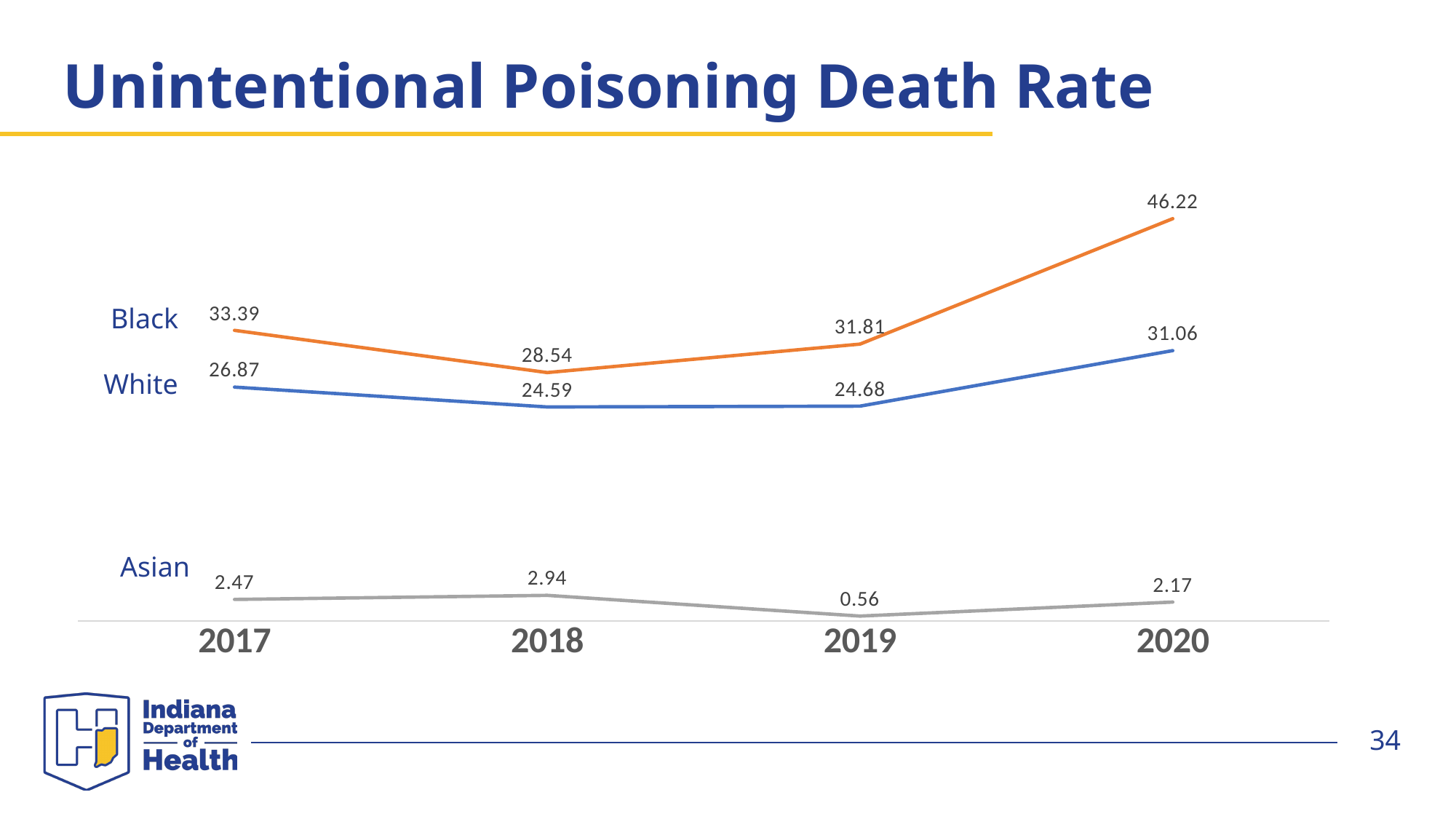
How many series are plotted on the chart? 3 What colour is the line for the Black series? Orange What is the unintentional poisoning death rate for White in 2018? 24.59 In which year is the Asian death rate lowest? 2019 How many years are shown on the x axis? 4 In which year is the Black death rate highest? 2020 What is the unintentional poisoning death rate for Asian in 2019? 0.56 What is the difference between the Black and White death rates in 2020? 15.16 What kind of chart is shown on the slide? Line chart Does the White death rate rise or fall from 2019 to 2020? Rise What is the unintentional poisoning death rate for Black in 2020? 46.22 Which is larger in 2017, the Black death rate or the White death rate? Black